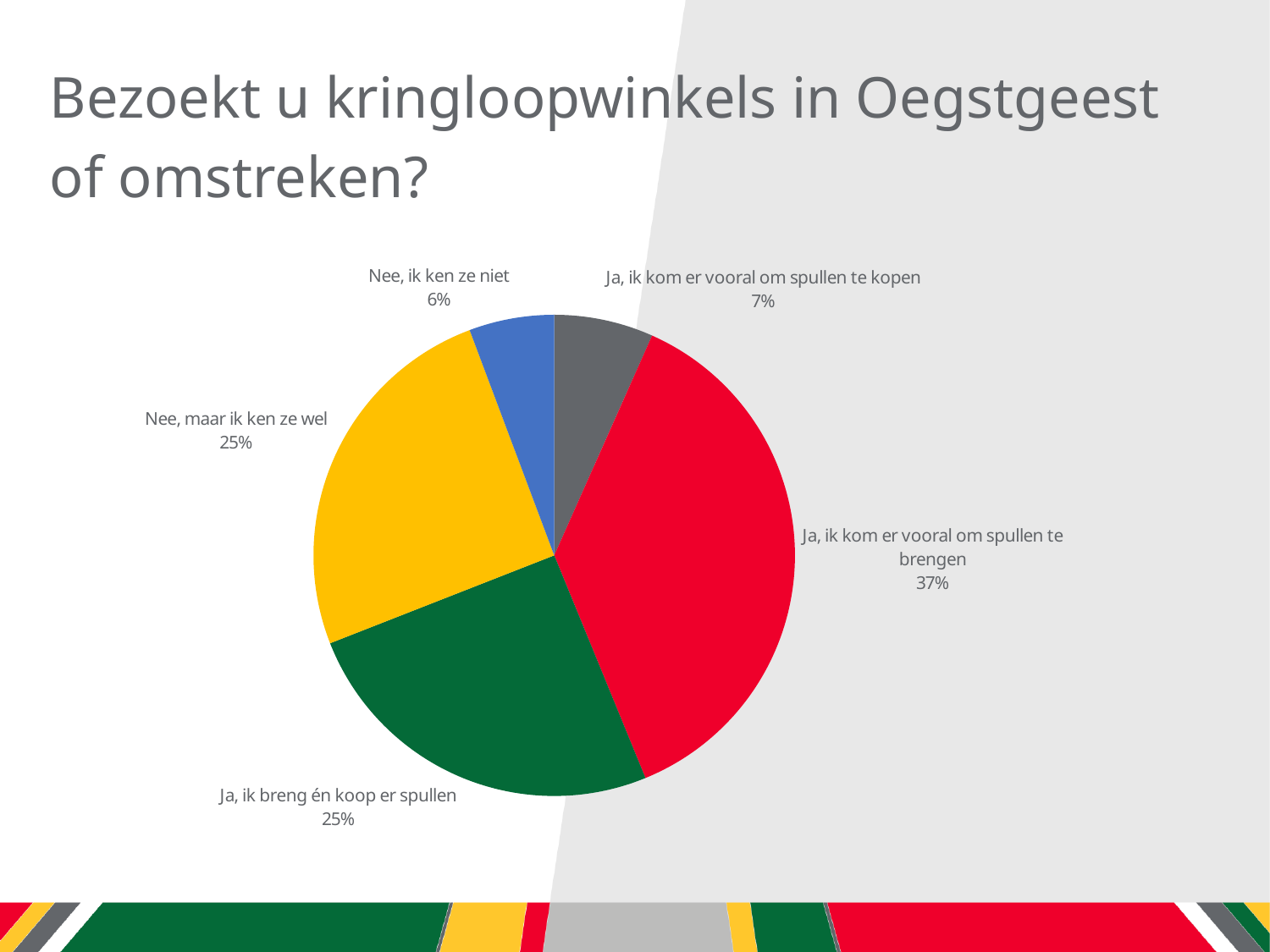
What is the difference in percentage points between "Ja, ik kom er vooral om spullen te brengen" and "Ja, ik breng én koop er spullen"? 12 Which is larger: the share for "Ja, ik kom er vooral om spullen te kopen" or for "Nee, ik ken ze niet"? Ja, ik kom er vooral om spullen te kopen What share of respondents answered "Ja, ik kom er vooral om spullen te brengen"? 37% How many slices does the pie chart have? 5 What share of respondents answered "Ja, ik kom er vooral om spullen te kopen"? 7% What kind of chart is shown on the slide? pie chart Which answer has the smallest slice of the pie? Nee, ik ken ze niet What share of respondents answered "Nee, ik ken ze niet"? 6% Which answer has the largest slice of the pie? Ja, ik kom er vooral om spullen te brengen What share of respondents answered "Nee, maar ik ken ze wel"? 25% What is the title of the slide containing the pie chart? Bezoekt u kringloopwinkels in Oegstgeest of omstreken? What colour is the slice for "Ja, ik breng én koop er spullen"? green